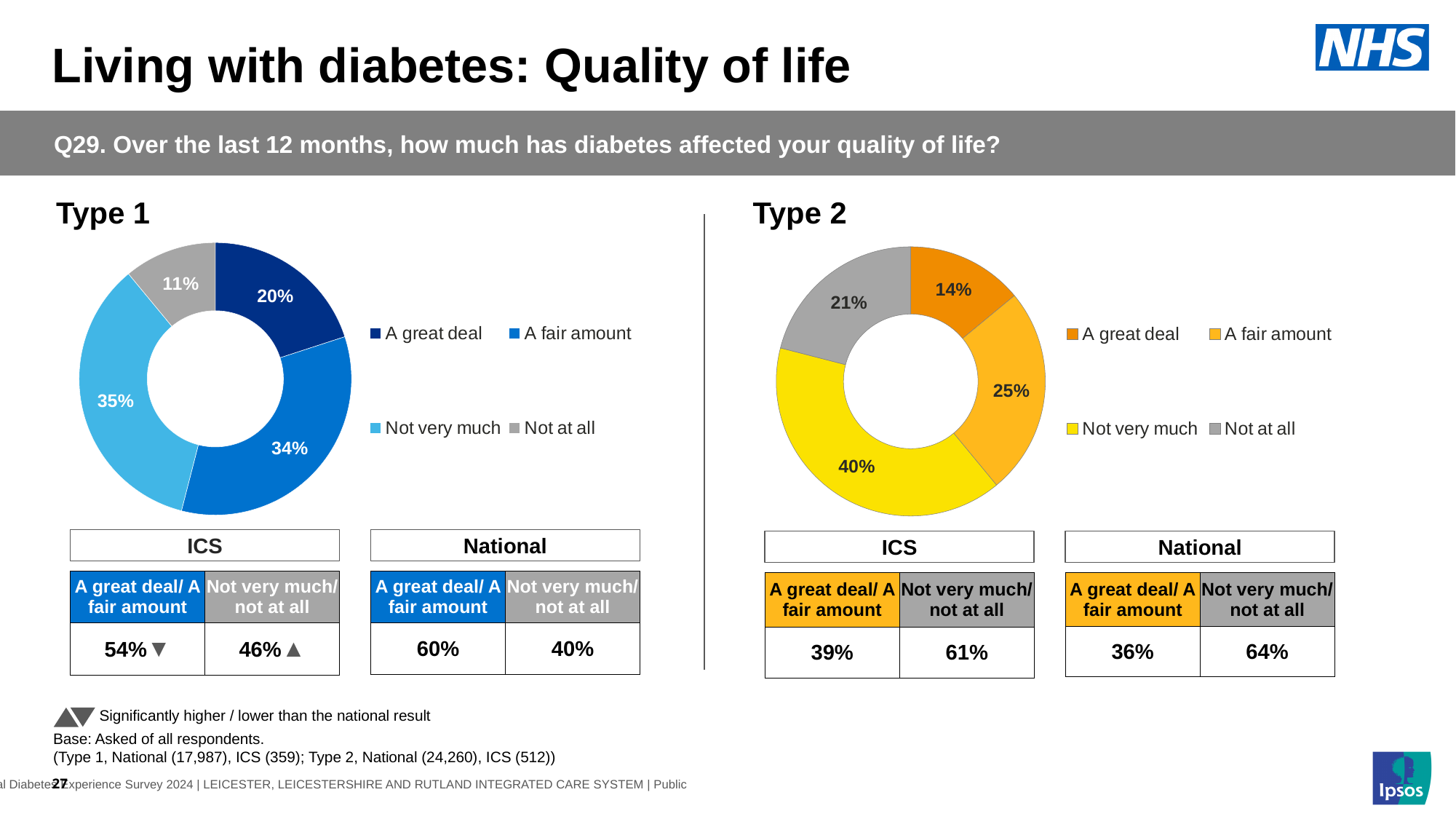
In the Type 1 chart, what percentage of respondents said diabetes affected their quality of life 'A great deal'? 20% How many entries does the legend of the Type 1 chart list? 4 In the Type 2 chart, what is the combined share of 'Not very much' and 'Not at all'? 61% In the Type 1 chart, what is the difference in percentage points between 'A fair amount' and 'Not at all'? 23 What kind of chart is used for Type 1? Doughnut chart In the Type 2 chart, which is larger: 'A fair amount' or 'Not at all'? A fair amount In the Type 1 chart, which response category has the largest share? Not very much In the Type 2 chart, what colour is the 'Not very much' slice? Yellow In the Type 2 chart, which response category has the smallest share? A great deal In the Type 2 chart, what percentage of respondents answered 'Not very much'? 40% In the Type 1 chart, what is the combined share of 'A great deal' and 'A fair amount'? 54% How many slices does the Type 2 chart have? 4